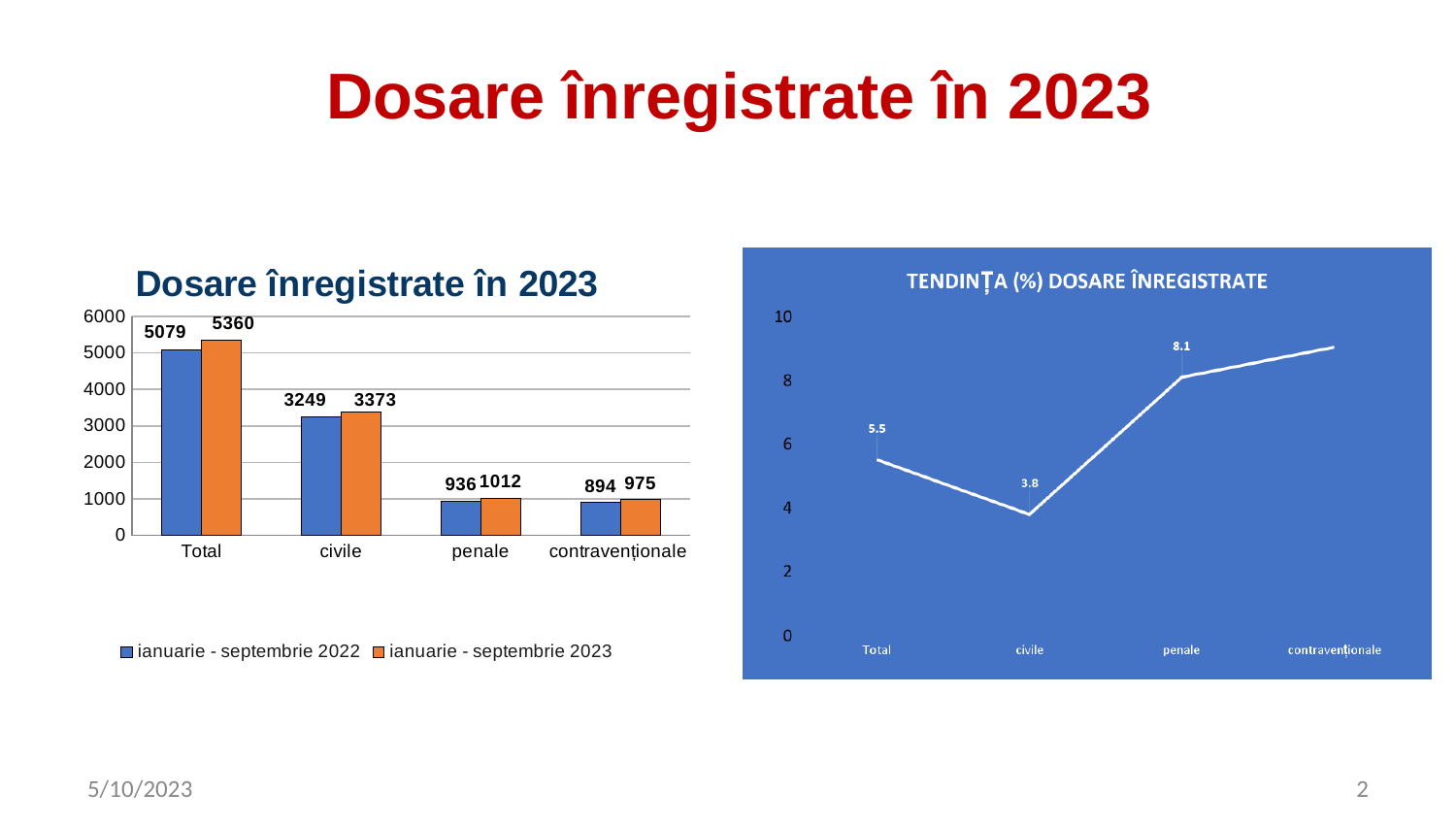
In the 'Dosare înregistrate în 2023' bar chart, how many categories are shown on the x axis? 4 In the 'Dosare înregistrate în 2023' bar chart, how many series does the legend list? 2 What kind of chart is the 'TENDINȚA (%) DOSARE ÎNREGISTRATE' chart on the right? line chart What kind of chart is the 'Dosare înregistrate în 2023' chart on the left? bar chart In the 'Dosare înregistrate în 2023' bar chart, what is the value for 'penale' in the 'ianuarie - septembrie 2022' series? 936 In the 'Dosare înregistrate în 2023' bar chart, which category has the lowest value in the 'ianuarie - septembrie 2022' series? contravenționale In the 'Dosare înregistrate în 2023' bar chart, what is the value for 'civile' in the 'ianuarie - septembrie 2023' series? 3373 In the 'TENDINȚA (%) DOSARE ÎNREGISTRATE' chart, is the value for 'contravenționale' greater or less than 8? greater In the 'Dosare înregistrate în 2023' bar chart, what is the difference between the 'Total' values for 2023 and 2022? 281 In the 'TENDINȚA (%) DOSARE ÎNREGISTRATE' chart, which is larger, the value for 'Total' or the value for 'civile'? Total In the 'TENDINȚA (%) DOSARE ÎNREGISTRATE' chart, what is the value for 'civile'? 3.8 In the 'TENDINȚA (%) DOSARE ÎNREGISTRATE' chart, what is the value for 'penale'? 8.1